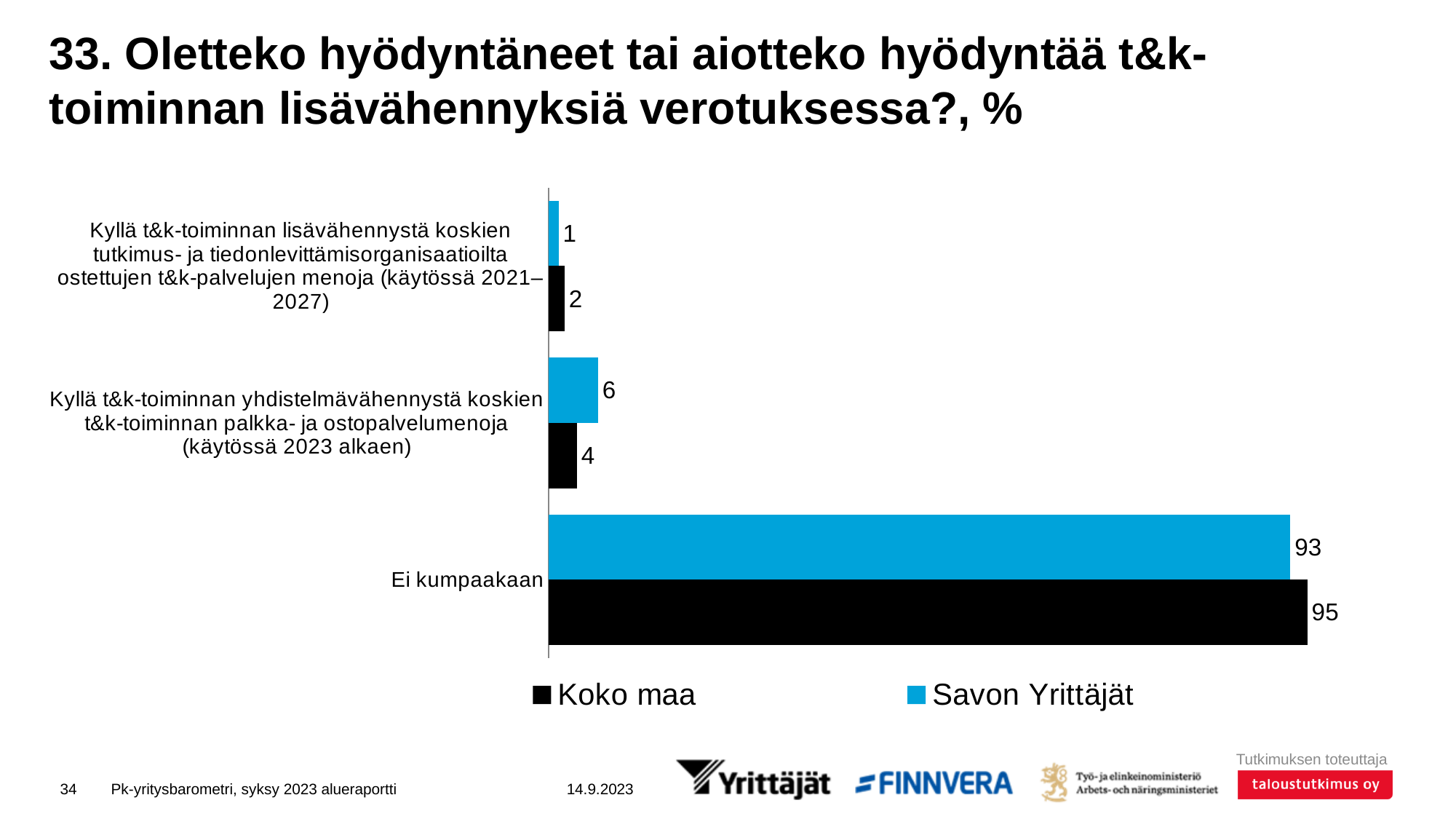
Which colour represents Savon Yrittäjät in the chart? Blue How many categories are shown on the chart? 3 Which category has the lowest value for Savon Yrittäjät? Kyllä t&k-toiminnan lisävähennystä koskien tutkimus- ja tiedonlevittämisorganisaatioilta ostettujen t&k-palvelujen menoja (käytössä 2021–2027) What kind of chart is shown on the slide? Bar chart What is the value for Koko maa for the category "Kyllä t&k-toiminnan yhdistelmävähennystä koskien t&k-toiminnan palkka- ja ostopalvelumenoja (käytössä 2023 alkaen)"? 4 For the category "Kyllä t&k-toiminnan yhdistelmävähennystä koskien t&k-toiminnan palkka- ja ostopalvelumenoja (käytössä 2023 alkaen)", which series has the larger value, Koko maa or Savon Yrittäjät? Savon Yrittäjät What is the difference between the Koko maa and Savon Yrittäjät values for "Ei kumpaakaan"? 2 What is the value for Savon Yrittäjät for the category "Kyllä t&k-toiminnan lisävähennystä koskien tutkimus- ja tiedonlevittämisorganisaatioilta ostettujen t&k-palvelujen menoja (käytössä 2021–2027)"? 1 What is the value for "Ei kumpaakaan" for Savon Yrittäjät? 93 How many series does the legend list? 2 What is the value for "Ei kumpaakaan" for Koko maa? 95 Which category has the highest value for Koko maa? Ei kumpaakaan